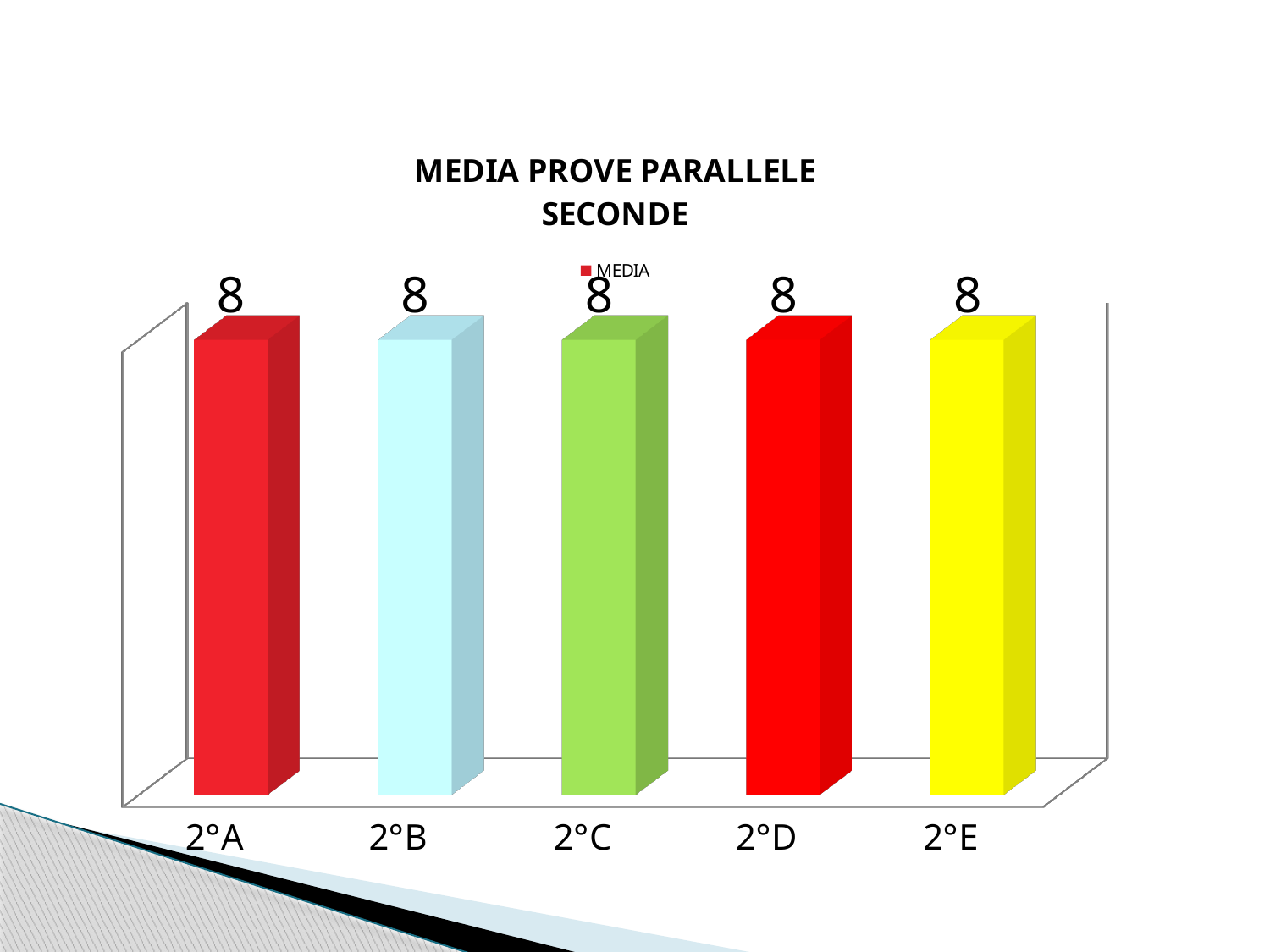
What is the title of the chart? MEDIA PROVE PARALLELE SECONDE What is the value for 2°C? 8 What is the name of the series listed in the legend? MEDIA How many categories are shown on the x axis? 5 What is the value for 2°D? 8 What is the difference between the values for 2°B and 2°D? 0 How many series does the legend list? 1 What is the value for 2°E? 8 Do the values rise, fall, or stay the same from 2°A to 2°E? stay the same What kind of chart is shown on the slide? bar chart What is the value for 2°A? 8